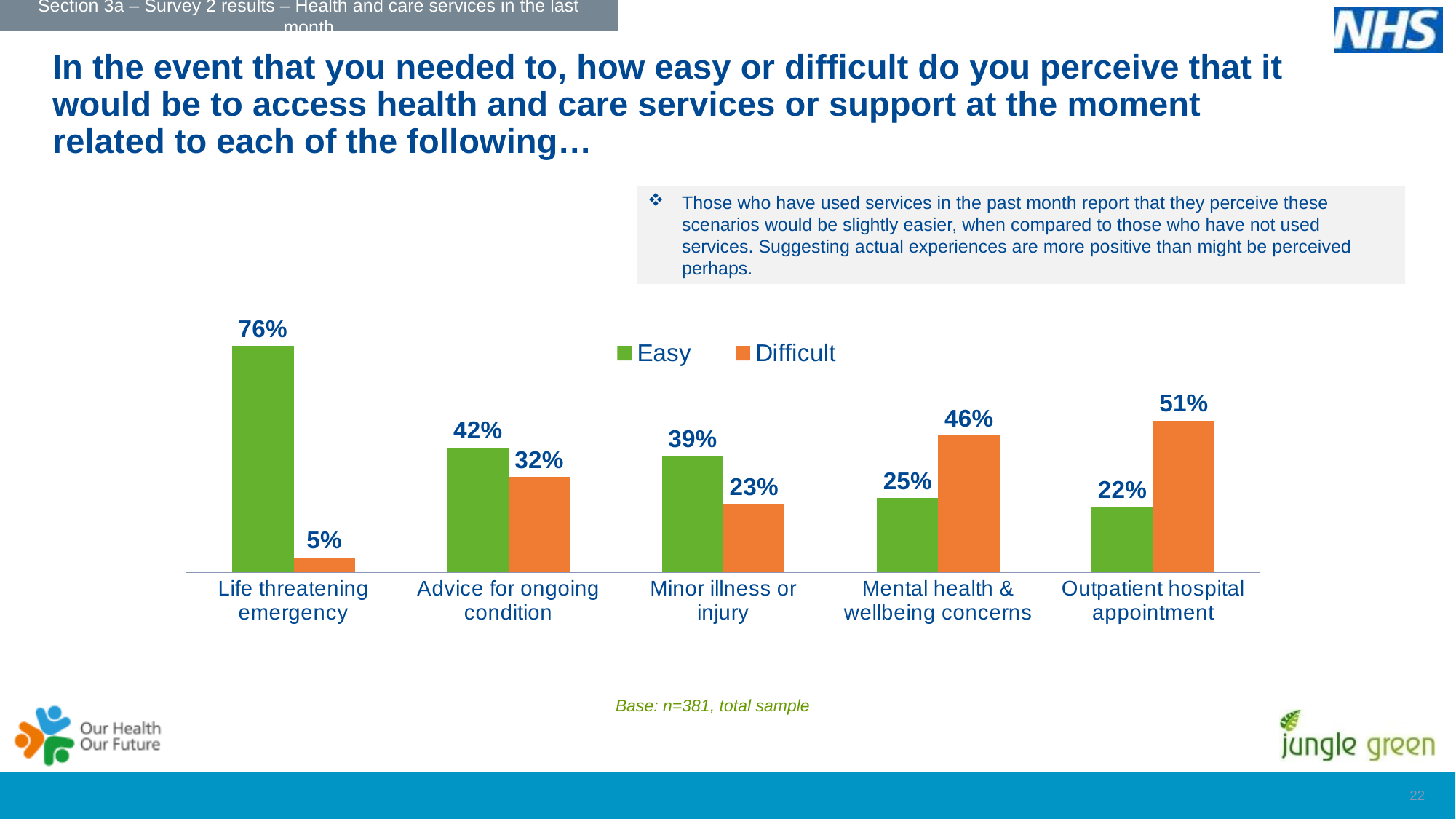
How many series does the legend list? 2 What is the Difficult value for Outpatient hospital appointment? 51% What is the difference between the Easy and Difficult values for Advice for ongoing condition? 10% Which colour represents the Difficult series in the chart? Orange How many categories are shown on the x axis of the chart? 5 What is the Difficult value for Mental health & wellbeing concerns? 46% What is the Easy value for Minor illness or injury? 39% Which category has the lowest Difficult value? Life threatening emergency What percentage of respondents said it would be easy to access services for a life threatening emergency? 76% Which category has the highest Easy value? Life threatening emergency What kind of chart is shown on the slide? Bar chart Which is larger for Outpatient hospital appointment, the Easy value or the Difficult value? Difficult